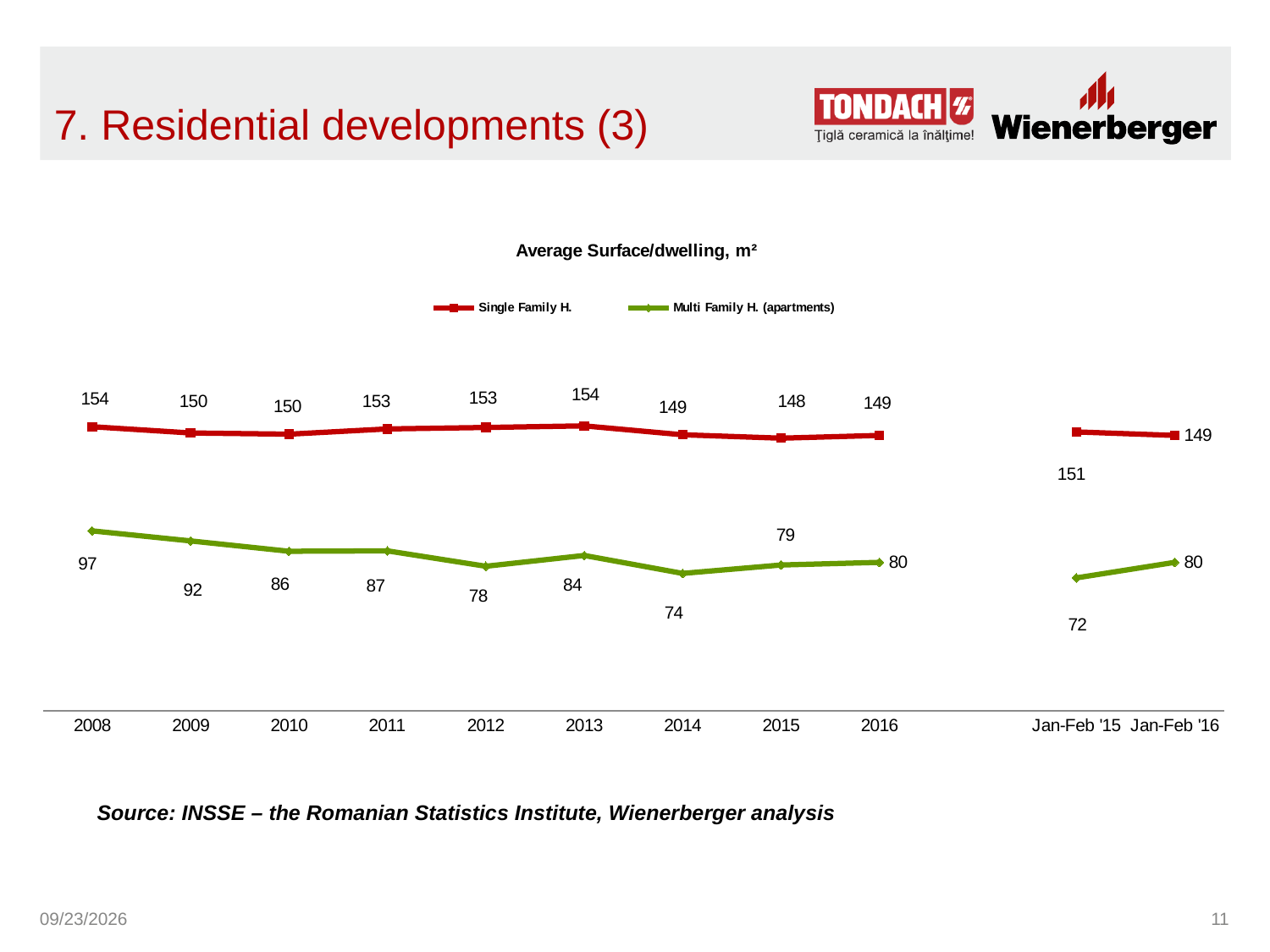
What is the difference between the Single Family H. and Multi Family H. (apartments) values in 2014? 75 In which period is the Multi Family H. (apartments) value lowest? Jan-Feb '15 What is the value for Multi Family H. (apartments) in Jan-Feb '15? 72 What is the value for Single Family H. in 2008? 154 In which year is the Multi Family H. (apartments) value highest? 2008 How many series does the legend list? 2 In which year is the Single Family H. value lowest? 2015 What kind of chart is shown on the slide? Line chart What is the title of the chart? Average Surface/dwelling, m² Which is larger: the Multi Family H. (apartments) value in 2013 or in 2015? 2013 What is the value for Single Family H. in Jan-Feb '16? 149 What is the value for Multi Family H. (apartments) in 2012? 78